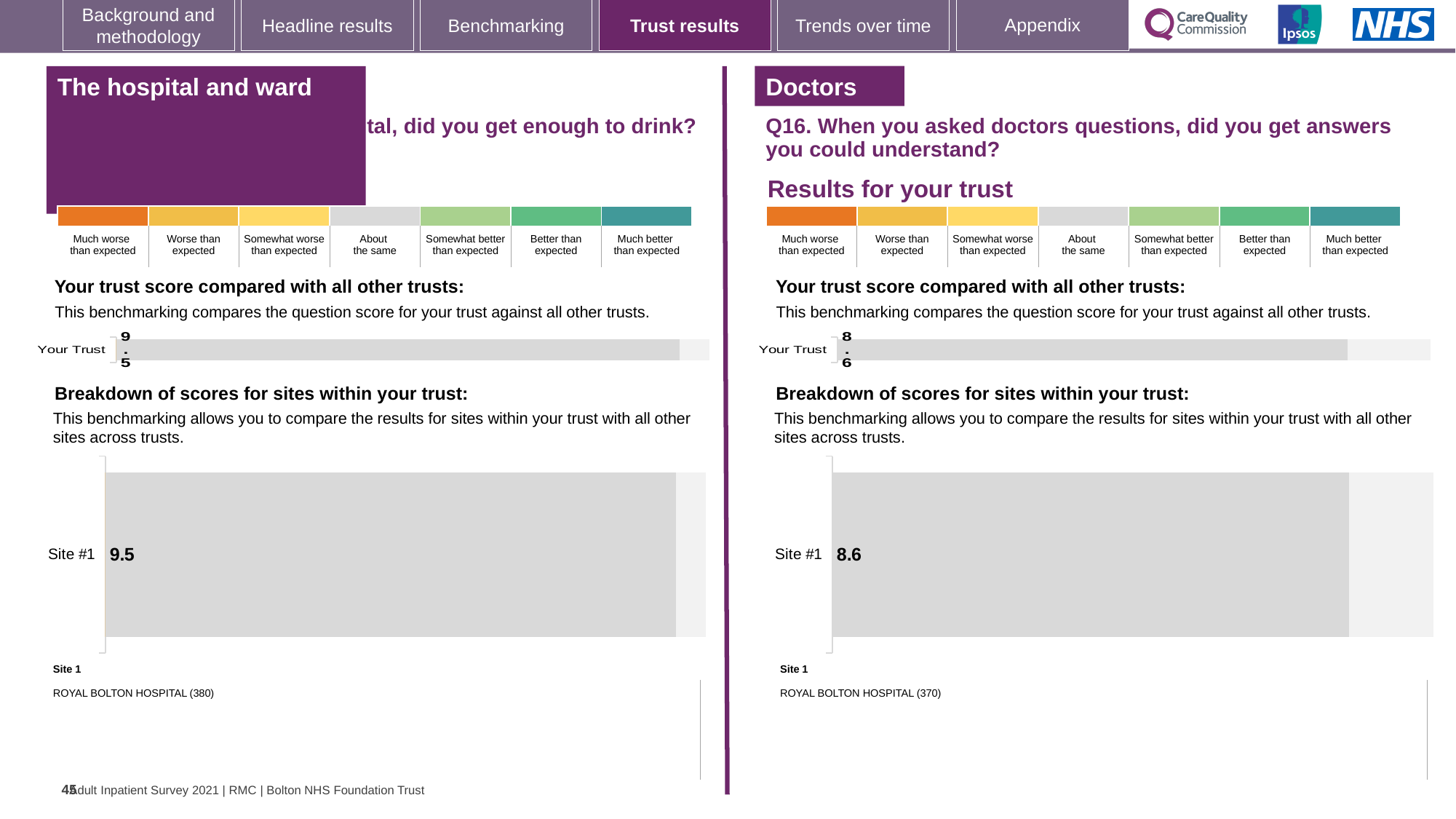
In the right-hand Q16 site breakdown, which site is listed as Site 1? ROYAL BOLTON HOSPITAL (370) How many rating bands are shown in the colour scale above the left-hand chart (from 'Much worse than expected' to 'Much better than expected')? 7 How many sites are shown in the left-hand 'Breakdown of scores for sites within your trust' chart? 1 In the right-hand 'Breakdown of scores for sites within your trust' chart for Q16, what is the score for Site #1? 8.6 Which is larger: the Your Trust score on the left-hand chart or the Your Trust score on the right-hand Q16 chart? The left-hand chart (9.5) Is the Site #1 score in the right-hand Q16 breakdown chart greater or less than 9? less On the right-hand chart for Q16 (doctors' answers you could understand), what is the score shown for Your Trust? 8.6 On the left-hand chart under 'The hospital and ward', what is the score shown for Your Trust? 9.5 What is the difference between the Your Trust score on the left-hand chart (9.5) and the Your Trust score on the right-hand Q16 chart (8.6)? 0.9 What kind of chart is used to show the Your Trust score on the right-hand Q16 section? Bar chart In the left-hand site breakdown, which site is listed as Site 1? ROYAL BOLTON HOSPITAL (380) In the left-hand 'Breakdown of scores for sites within your trust' chart, what is the score for Site #1? 9.5